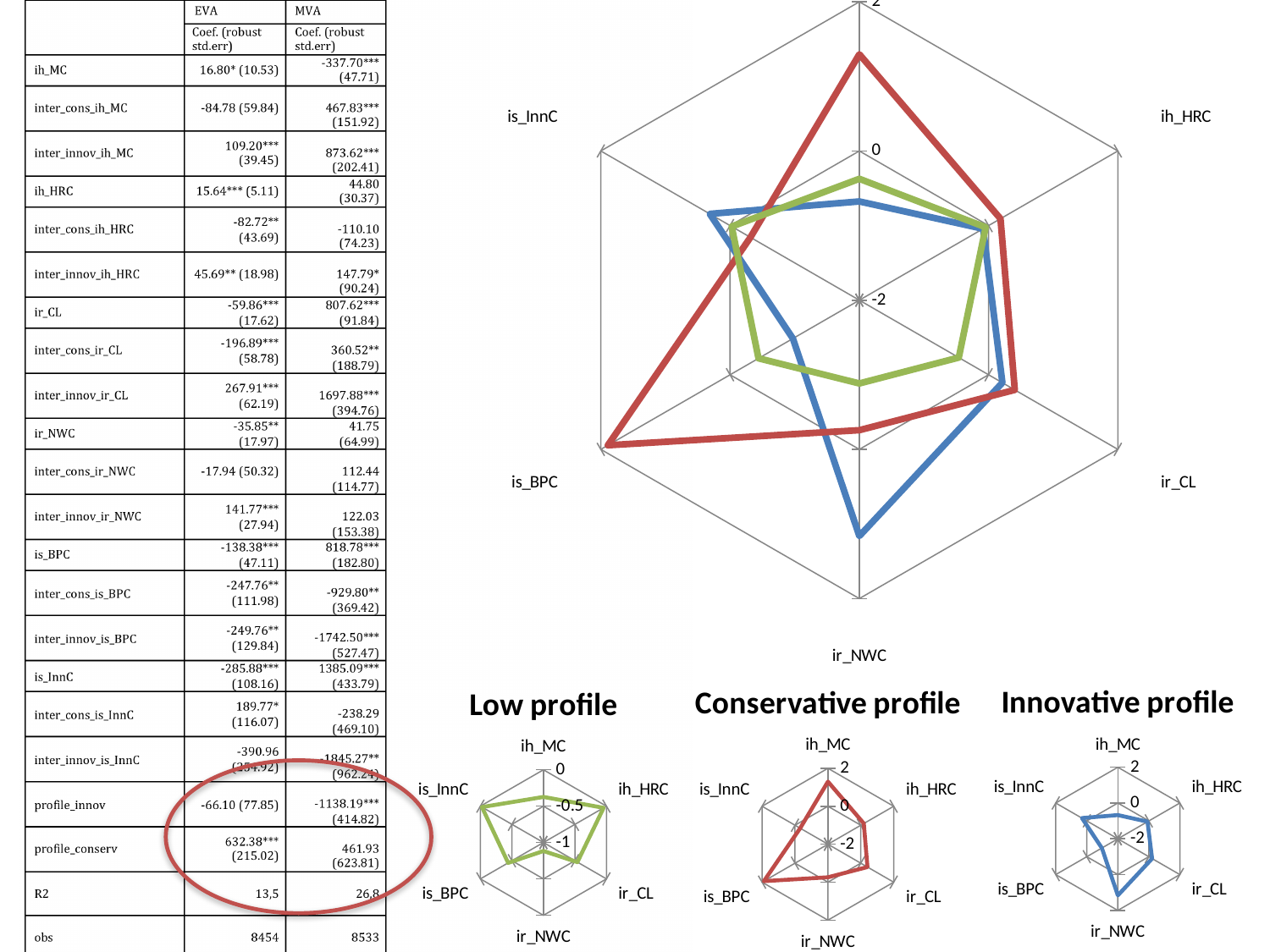
On the large radar chart at the top right, is the value of the red series on the ih_MC axis greater or less than 0? greater On the large radar chart at the top right, which series has the larger value on the ir_NWC axis, the blue series or the green series? blue On the Conservative profile radar chart, is the value on the is_BPC axis greater or less than 0? greater How many axes (categories) does the large radar chart at the top right have? 6 How many data series are plotted on the large radar chart at the top right? 3 On the Innovative profile radar chart, is the value on the ir_NWC axis greater or less than 0? greater What kind of chart is the large chart at the top right of the slide? radar chart What are the titles of the three small radar charts at the bottom right of the slide? Low profile, Conservative profile, Innovative profile On the large radar chart at the top right, which series has the larger value on the is_BPC axis, the red series or the blue series? red What axis tick values are shown on the Low profile radar chart? 0, -0.5, -1